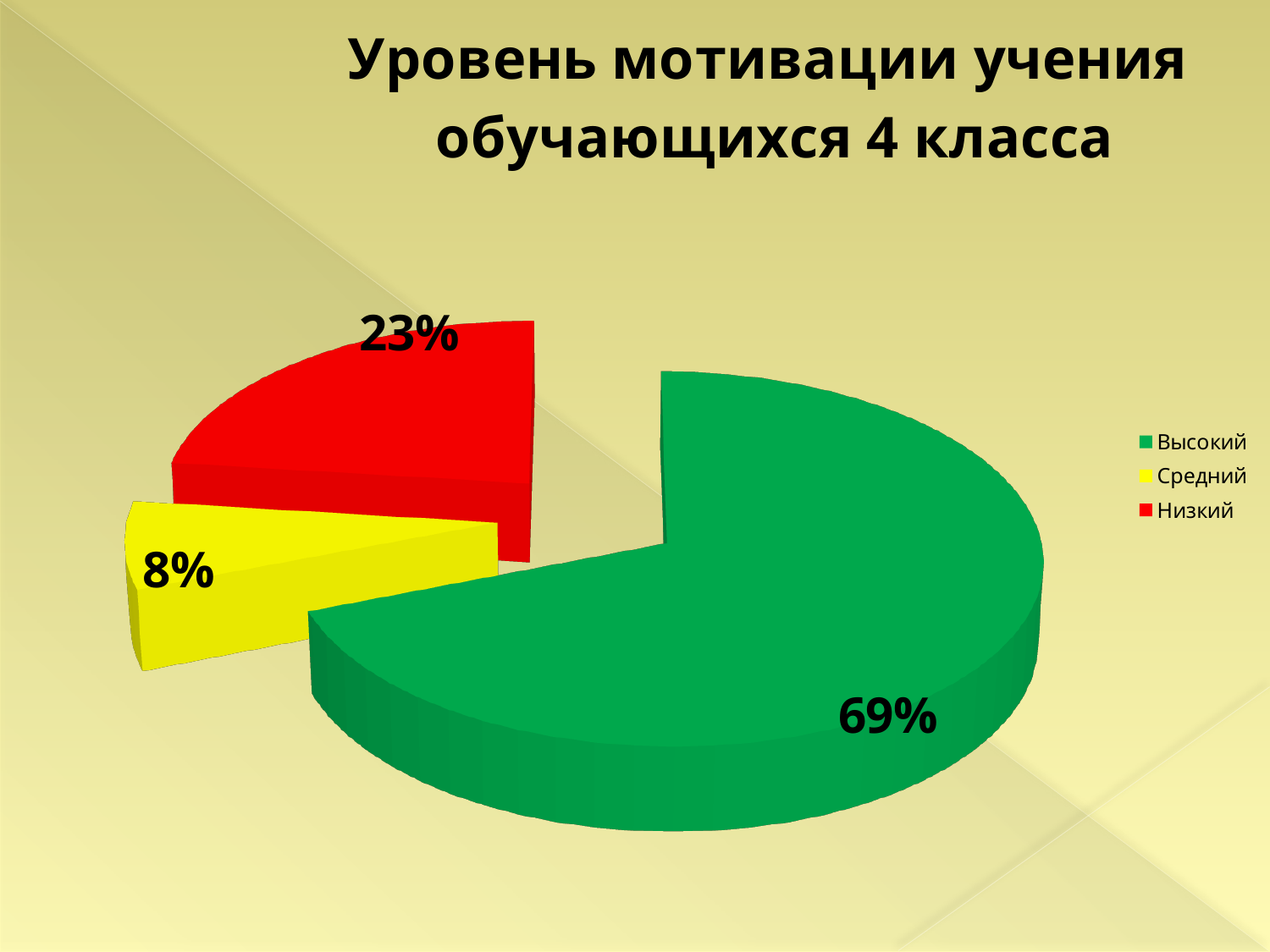
Which is larger, the Низкий slice or the Средний slice? Низкий What colour is the Низкий slice? Red What share of the pie does the Средний slice represent? 8% What is the difference in percentage points between the Высокий and Низкий slices? 46 What is the difference in percentage points between the Низкий and Средний slices? 15 Which category has the smallest slice of the pie? Средний What share of the pie does the Низкий slice represent? 23% Which category has the largest slice of the pie? Высокий How many slices does the pie chart have? 3 What kind of chart is shown on the slide? Pie chart What share of the pie does the Высокий slice represent? 69% How many entries does the legend list? 3